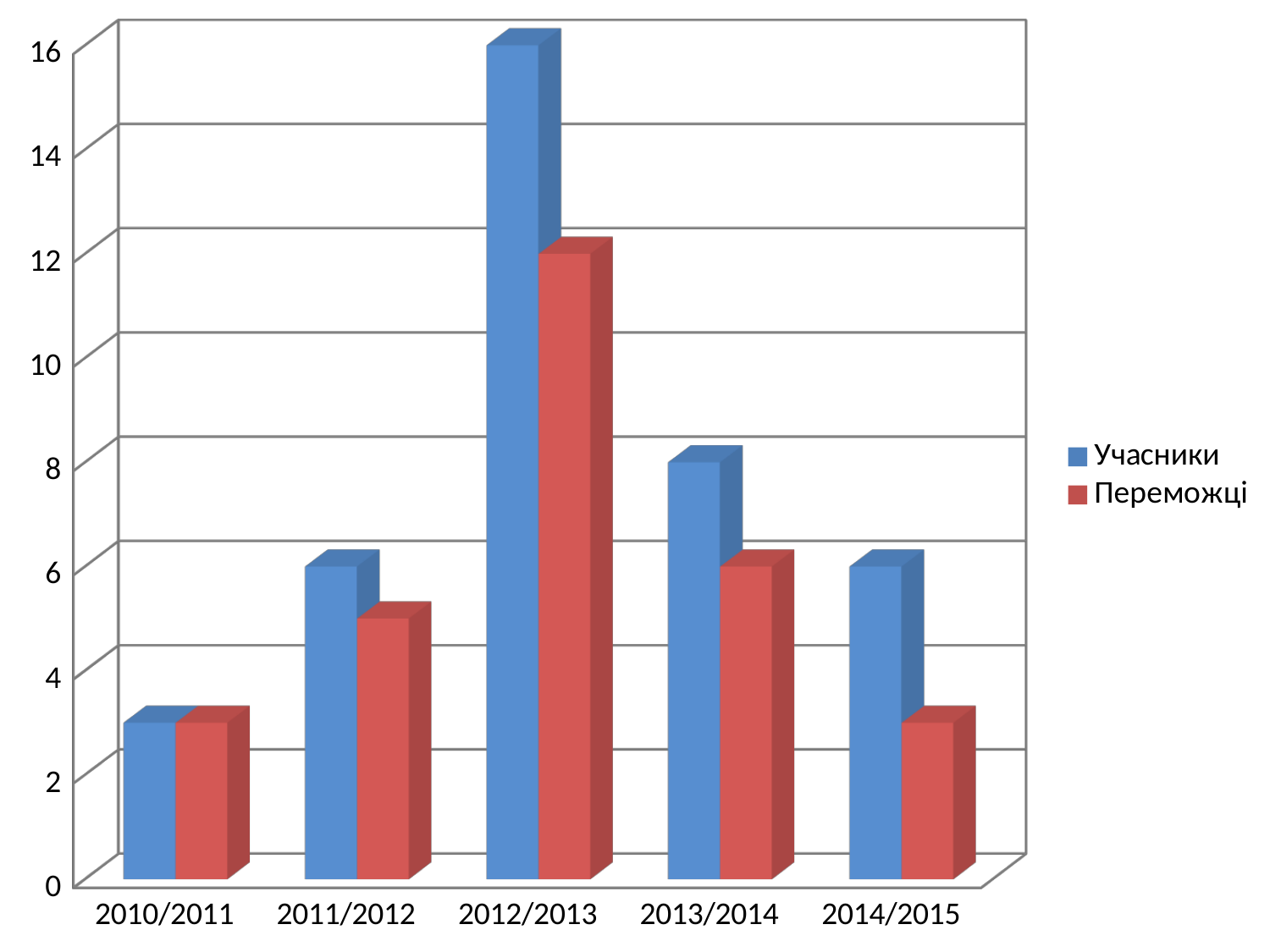
What kind of chart is shown on the slide? bar chart Is the value for Учасники in 2012/2013 greater or less than 14? greater How many series does the legend list? 2 In which season is the value for Учасники highest? 2012/2013 Is the value for Переможці in 2012/2013 greater or less than 10? greater How many categories (seasons) are shown on the x axis? 5 In which season is the value for Переможці highest? 2012/2013 Is the value for Переможці in 2014/2015 greater or less than 4? less What colour are the bars for the Учасники series? blue In which season is the value for Учасники lowest? 2010/2011 Which season has the larger value for Учасники: 2013/2014 or 2014/2015? 2013/2014 Which is larger in 2012/2013: Учасники or Переможці? Учасники